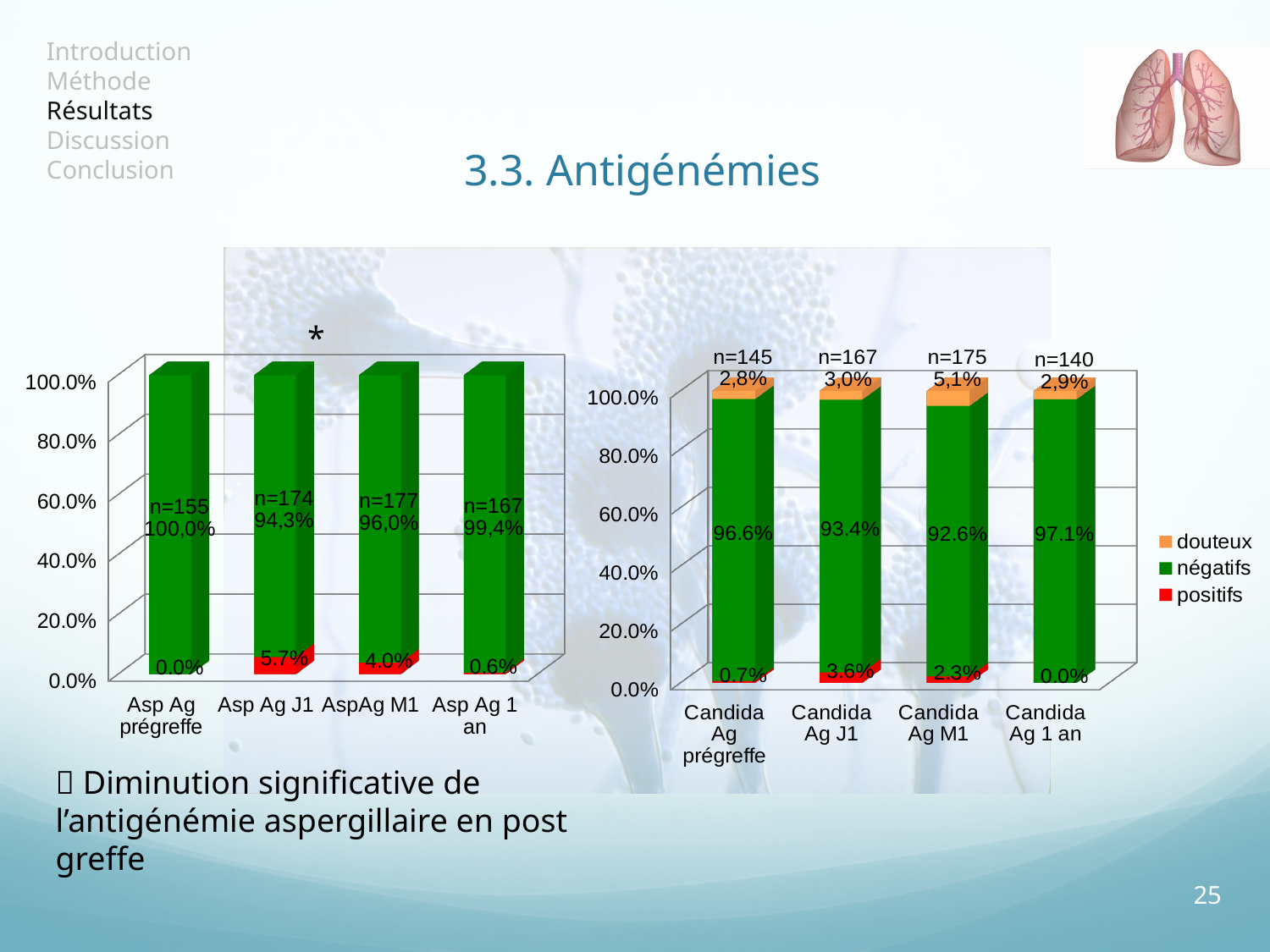
In the right chart (Candida Ag), what is the difference between the positifs percentage for Candida Ag J1 and Candida Ag M1? 1.3% How many series does the legend on the right chart list? 3 In the left chart (Asp Ag), what is the percentage of positifs for Asp Ag J1? 5.7% In the right chart (Candida Ag), which category has the lowest percentage of négatifs? Candida Ag M1 In the right chart (Candida Ag), which is larger: the positifs percentage for Candida Ag prégreffe or for Candida Ag J1? Candida Ag J1 In the right chart (Candida Ag), what is the percentage of négatifs for Candida Ag prégreffe? 96.6% How many categories are shown on the x axis of the left chart (Asp Ag)? 4 In the right chart (Candida Ag), what is the percentage of douteux for Candida Ag M1? 5,1% What kind of chart is the right chart (Candida Ag)? Stacked bar chart In the left chart (Asp Ag), which category has the highest percentage of positifs? Asp Ag J1 In the left chart (Asp Ag), what is the n value shown for AspAg M1? n=177 In the left chart (Asp Ag), what is the percentage of négatifs for Asp Ag 1 an? 99,4%